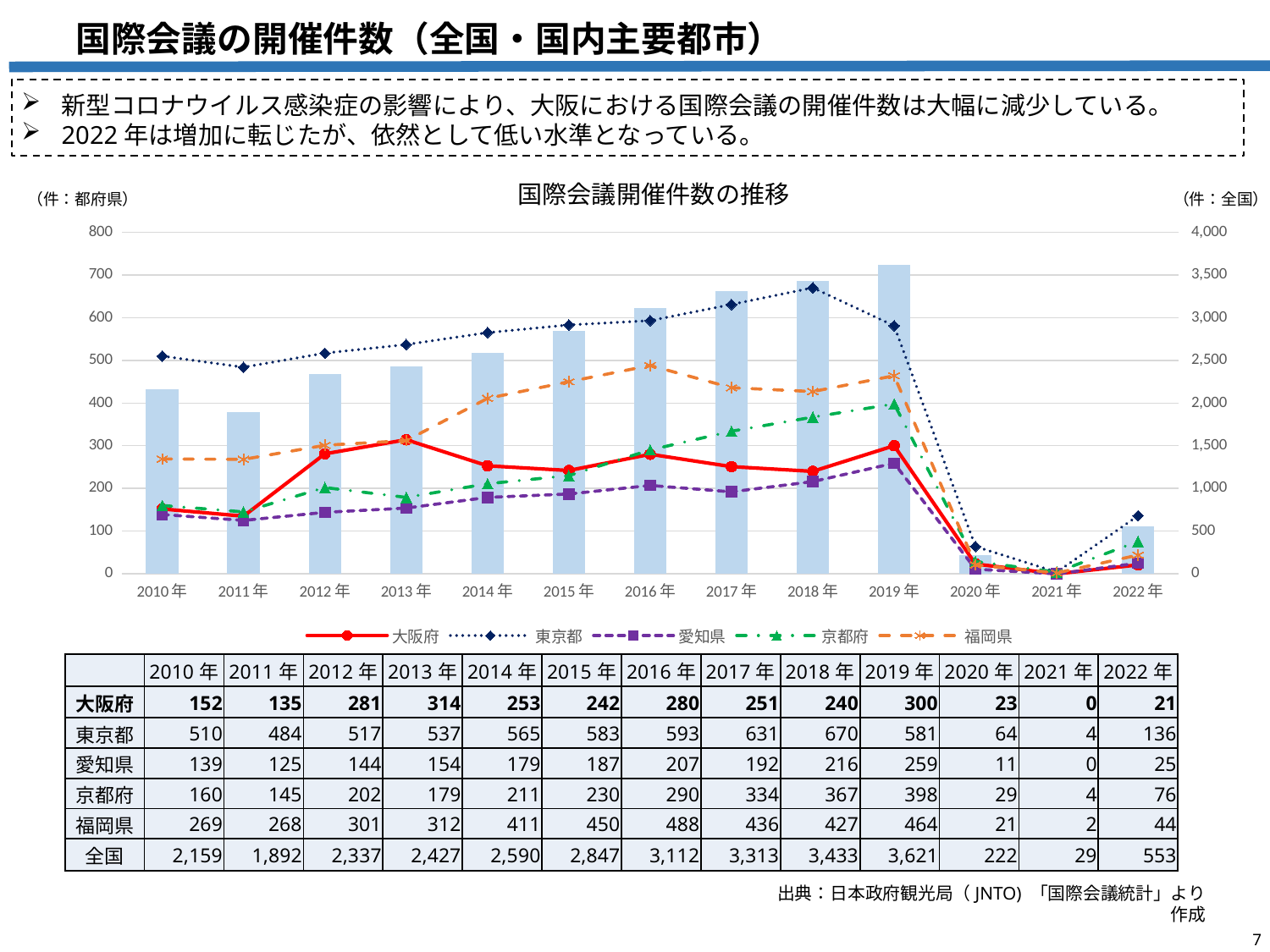
How many years are shown on the x axis of the chart? 13 Did the 全国 total of international conferences rise or fall from 2010年 to 2019年? rise In which year was the 全国 total of international conferences lowest? 2021年 What was the number of international conferences held in 大阪府 in 2019年? 300 What was the number of international conferences held in 東京都 in 2018年? 670 What kind of chart is used to show the 全国 values? bar chart Which had more international conferences in 2016年, 京都府 or 大阪府? 京都府 What is the title of the chart? 国際会議開催件数の推移 What was the 全国 total of international conferences in 2022年? 553 What is the difference between the 全国 totals for 2019年 and 2020年? 3,399 How many series does the chart legend list? 5 In which year did 大阪府 record its highest number of international conferences? 2013年